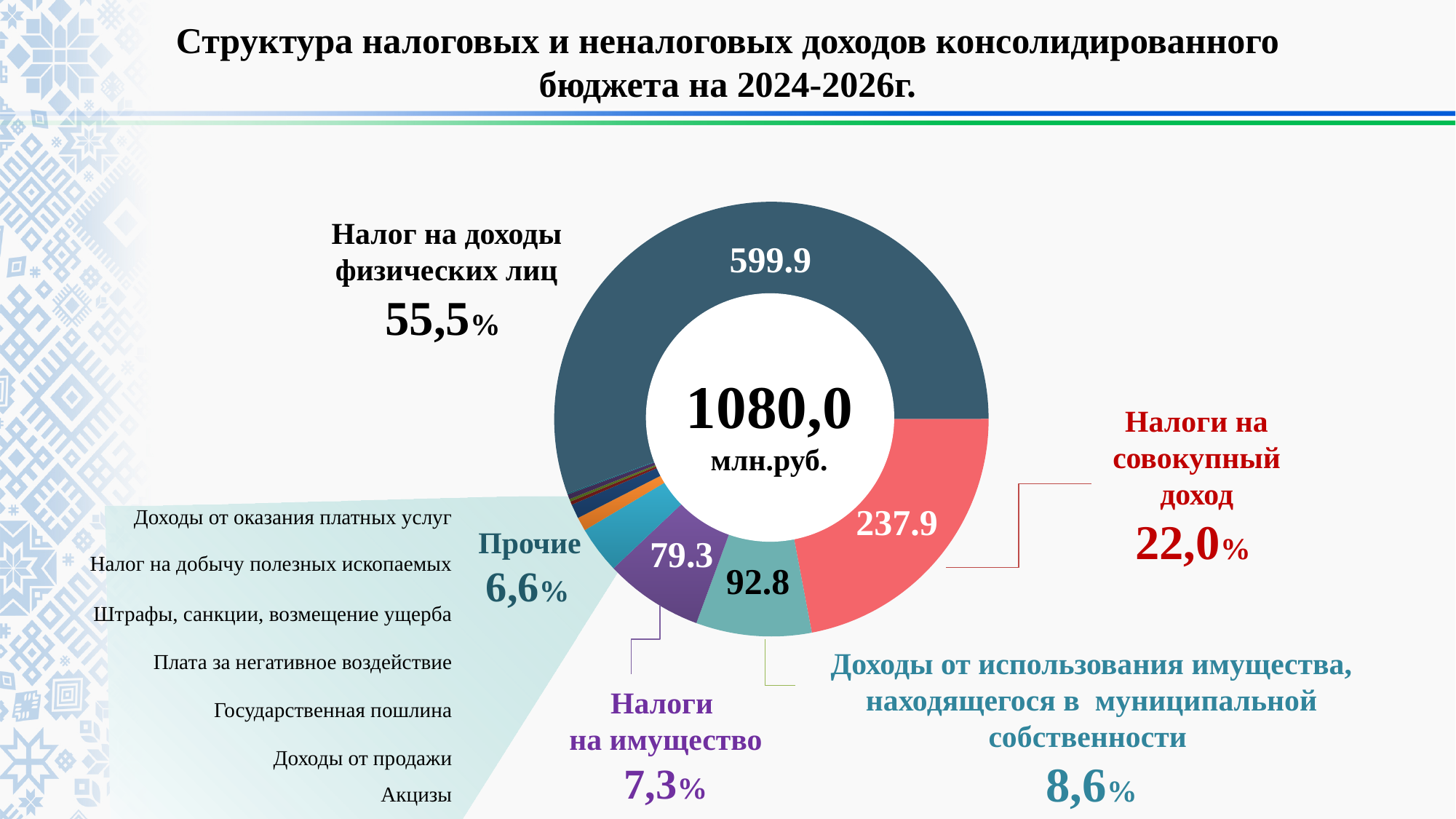
What value is shown for the segment labelled "Налог на доходы физических лиц"? 599.9 How many items are listed under the "Прочие" group? 7 What value is shown for the segment labelled "Налоги на имущество"? 79.3 What share of the total does "Налог на доходы физических лиц" account for? 55,5% What share of the total does "Прочие" account for? 6,6% Which segment of the chart is the largest? Налог на доходы физических лиц What value is shown for the segment "Доходы от использования имущества, находящегося в муниципальной собственности"? 92.8 What is the difference between the values for "Налог на доходы физических лиц" and "Налоги на совокупный доход"? 362.0 What total is shown in the centre of the chart? 1080,0 млн.руб. What kind of chart is shown on the slide? doughnut chart Which is larger: the value for "Налоги на имущество" or the value for "Доходы от использования имущества, находящегося в муниципальной собственности"? Доходы от использования имущества, находящегося в муниципальной собственности What value is shown for the segment labelled "Налоги на совокупный доход"? 237.9